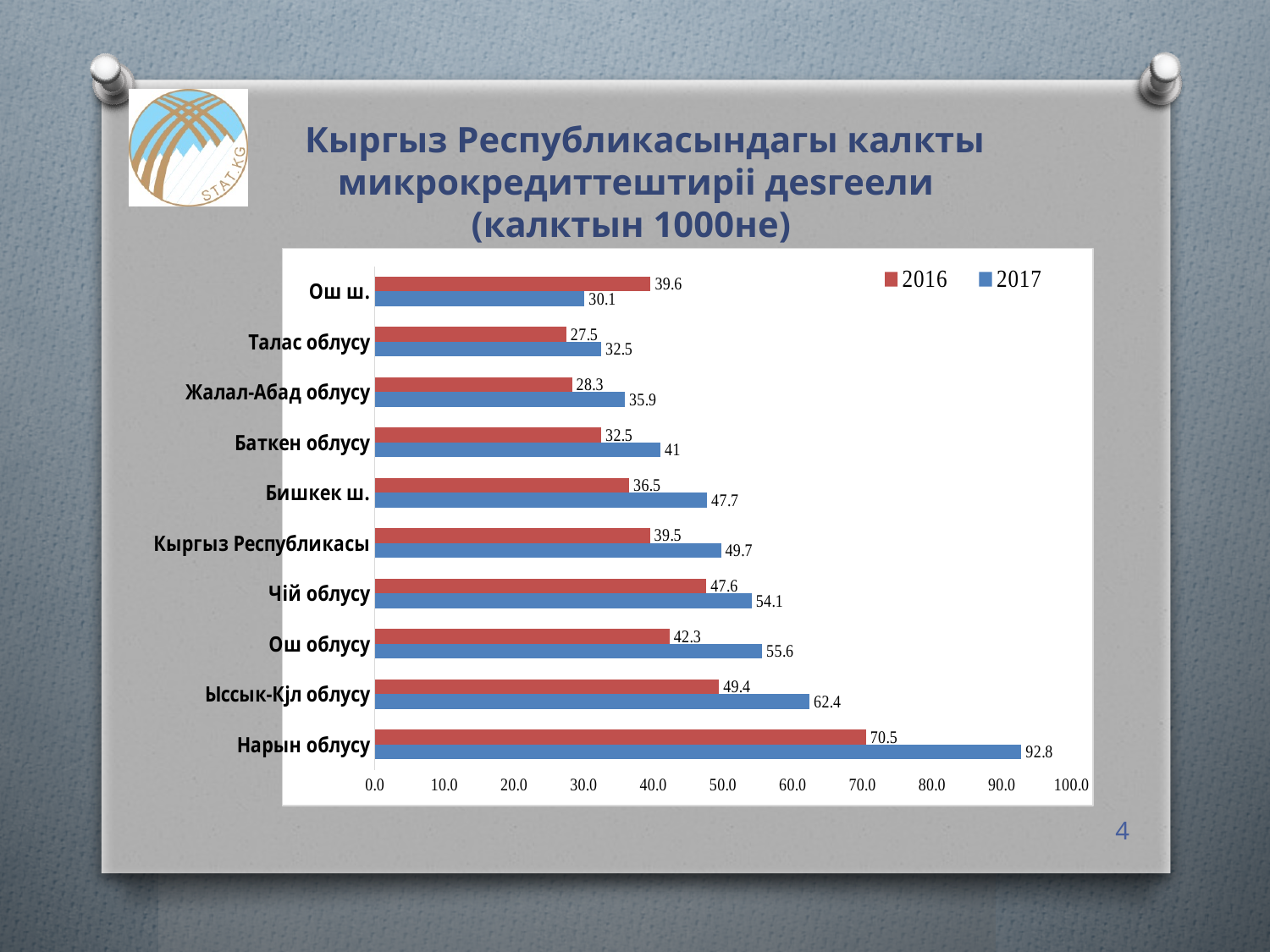
Which category has the lowest 2016 value? Талас облусу What type of chart is shown on the slide? bar chart Which category has the highest 2017 value? Нарын облусу What is the 2016 value for Ош ш.? 39.6 Is the 2017 value for Ыссык-Кјл облусу greater or less than 60.0? greater How many series does the legend list? 2 Which colour represents the 2017 series in the legend? blue What is the 2017 value for Бишкек ш.? 47.7 How many categories are shown on the chart? 10 For Ош ш., which is larger, the 2016 value or the 2017 value? 2016 What is the difference between the 2017 and 2016 values for Ош облусу? 13.3 What is the 2017 value for Нарын облусу? 92.8